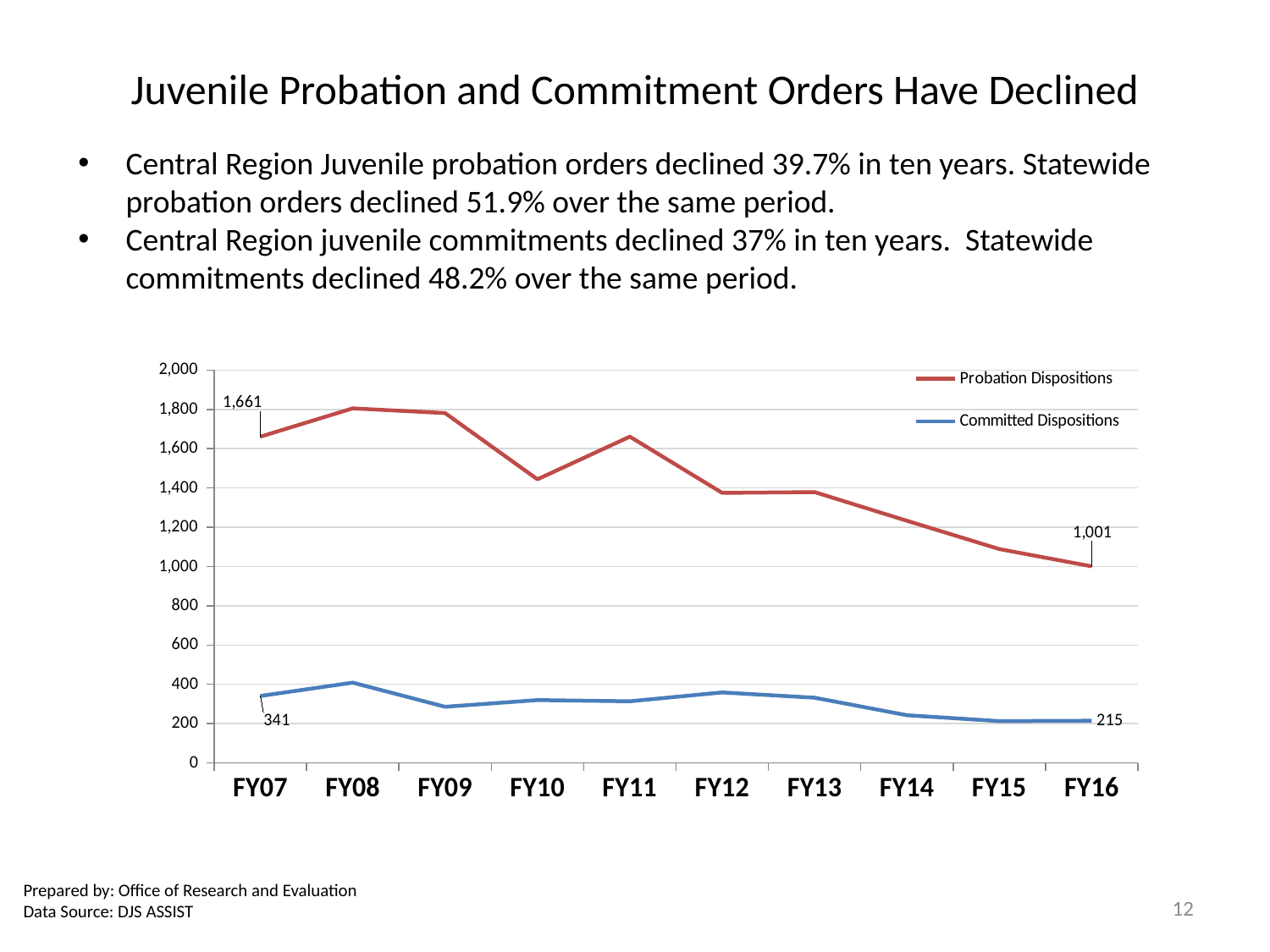
Which fiscal year has the highest value for Probation Dispositions? FY08 What kind of chart is shown on the slide? Line chart What is the value of Probation Dispositions in FY07? 1,661 Is the value for Probation Dispositions in FY10 greater or less than 1,600? less What is the value of Committed Dispositions in FY16? 215 By how much did Probation Dispositions decline from FY07 to FY16? 660 What is the value of Committed Dispositions in FY07? 341 Is the value for Committed Dispositions in FY12 greater or less than 200? greater Which fiscal year has the highest value for Committed Dispositions? FY08 By how much did Committed Dispositions decline from FY07 to FY16? 126 How many series does the legend list? 2 What is the value of Probation Dispositions in FY16? 1,001